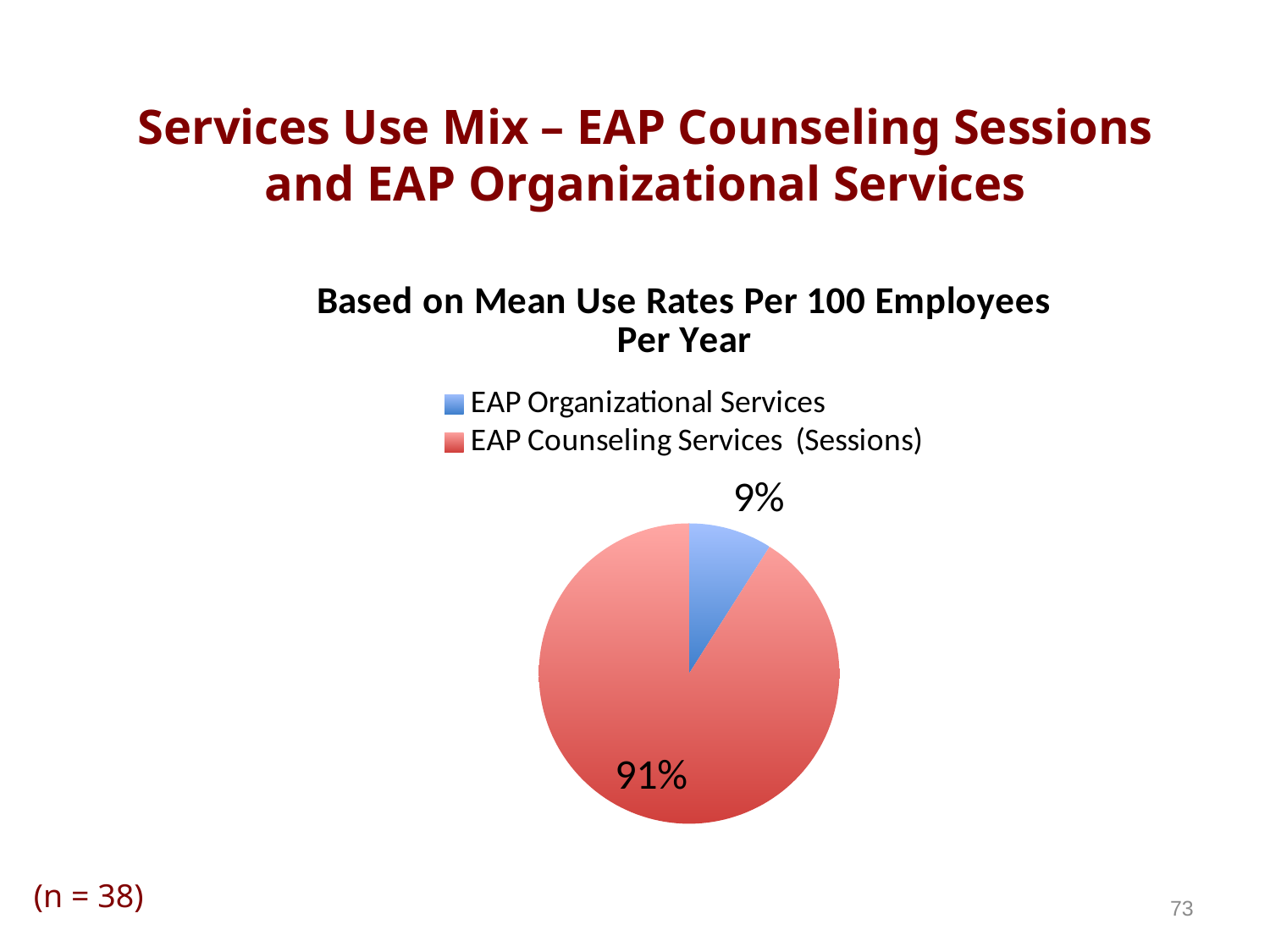
What is the title of the chart? Based on Mean Use Rates Per 100 Employees Per Year What share of the pie does EAP Organizational Services represent? 9% What kind of chart is shown on the slide? pie chart Which slice of the pie is the largest? EAP Counseling Services (Sessions) Which is larger: the share for EAP Organizational Services or the share for EAP Counseling Services (Sessions)? EAP Counseling Services (Sessions) How many entries does the legend list? 2 What is the difference in percentage points between the EAP Counseling Services (Sessions) slice and the EAP Organizational Services slice? 82 What colour is the EAP Organizational Services slice? blue How many slices does the pie chart have? 2 Which slice of the pie is the smallest? EAP Organizational Services What share of the pie does EAP Counseling Services (Sessions) represent? 91%